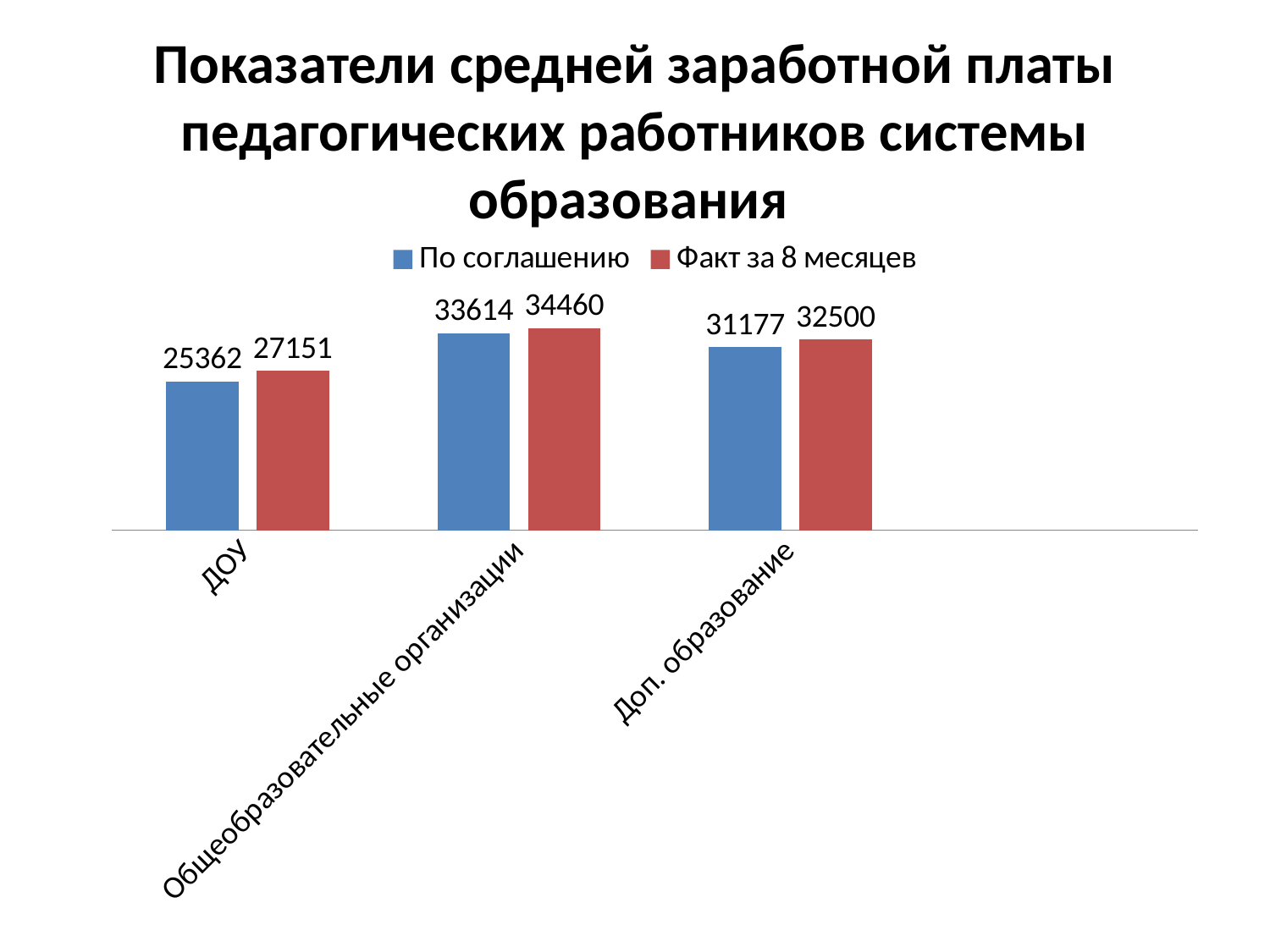
What is the value for Доп. образование in the Факт за 8 месяцев series? 32500 What is the value for ДОУ in the По соглашению series? 25362 What kind of chart is shown on the slide? Bar chart What is the difference between the Факт за 8 месяцев and По соглашению values for ДОУ? 1789 How many categories are shown on the x axis? 3 Which category has the lowest value in the Факт за 8 месяцев series? ДОУ What is the value for Общеобразовательные организации in the Факт за 8 месяцев series? 34460 Which colour represents the Факт за 8 месяцев series? Red Which is larger for Общеобразовательные организации: По соглашению or Факт за 8 месяцев? Факт за 8 месяцев What is the difference between the Факт за 8 месяцев and По соглашению values for Доп. образование? 1323 How many series does the legend list? 2 Which category has the highest value in the По соглашению series? Общеобразовательные организации